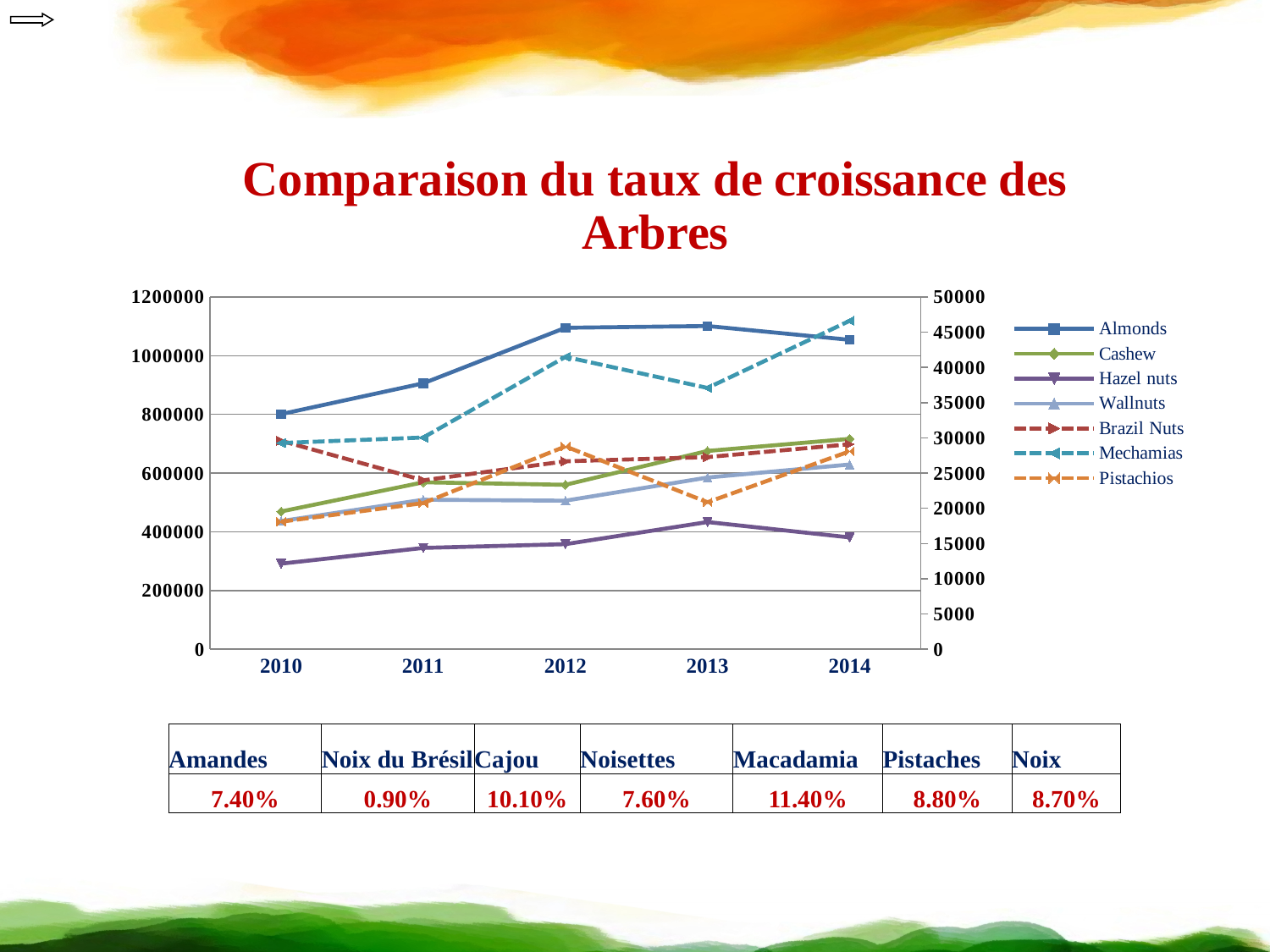
How many years are shown along the x axis of the chart? 5 Which year is the first on the x axis of the chart? 2010 How many series does the chart legend list? 7 Which series is drawn with the dark blue solid line with square markers? Almonds Is the value for Almonds in 2012 greater or less than 1000000 on the left axis? greater Which is larger in 2013, the value for Almonds or the value for Hazel nuts? Almonds Is the value for Almonds in 2010 greater or less than 1000000 on the left axis? less Among the solid-line series, which has the lowest value in 2014? Hazel nuts Does the Cashew line rise or fall from 2010 to 2014? rise What kind of chart is shown on the slide? line chart Among the solid-line series, which has the highest value in 2012? Almonds Is the value for Hazel nuts in 2010 greater or less than 400000 on the left axis? less